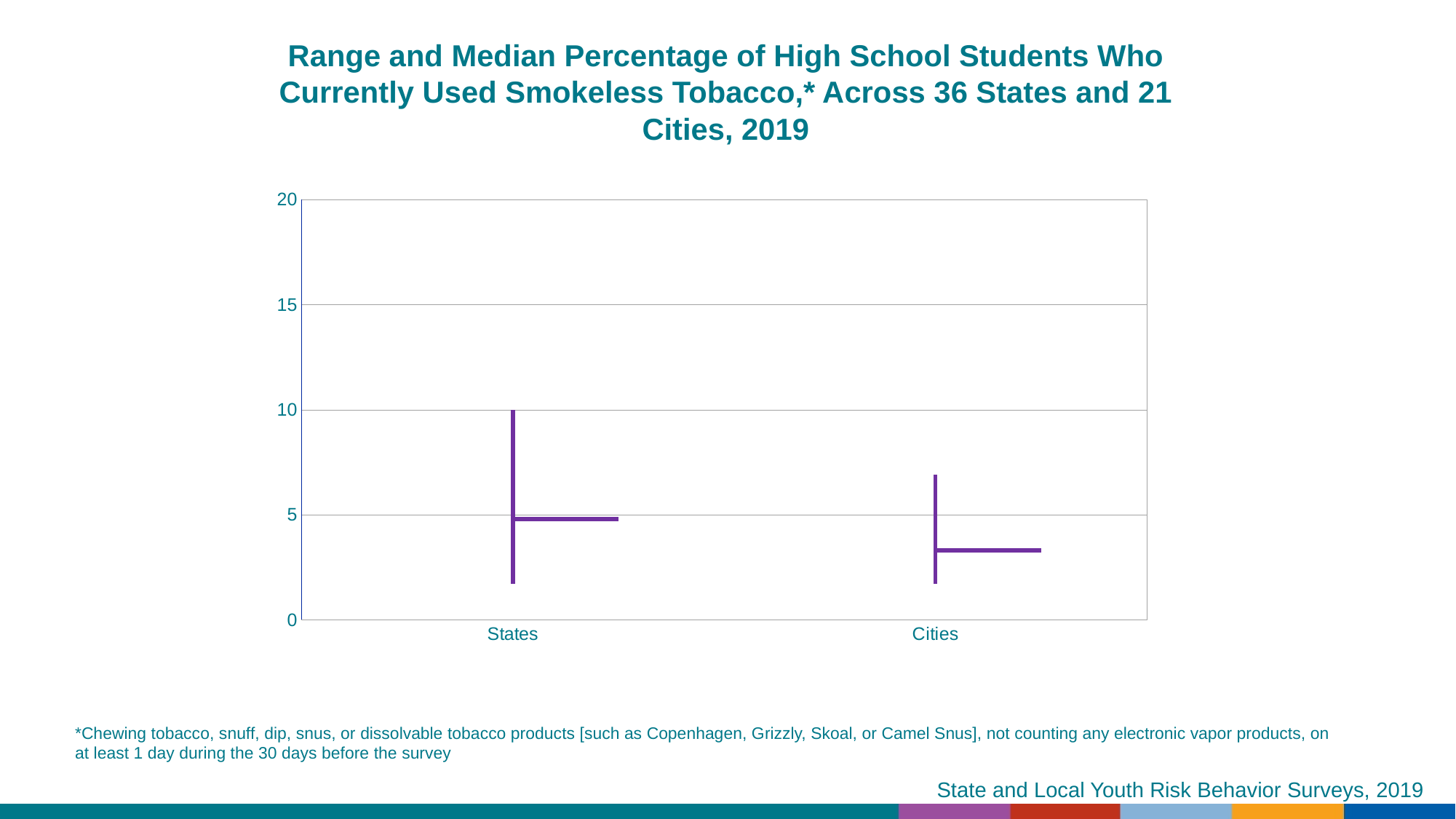
Is the top of the range for States greater or less than 5? greater According to the chart title, how many states are included in the data? 36 Which category has the higher median percentage, States or Cities? States Is the top of the range for Cities greater or less than 10? less Is the median value for Cities greater or less than 5? less What is the highest value shown on the y axis? 20 How many categories are shown on the x axis of the chart? 2 What are the two categories shown on the x axis? States and Cities Which category has the higher top of its range? States